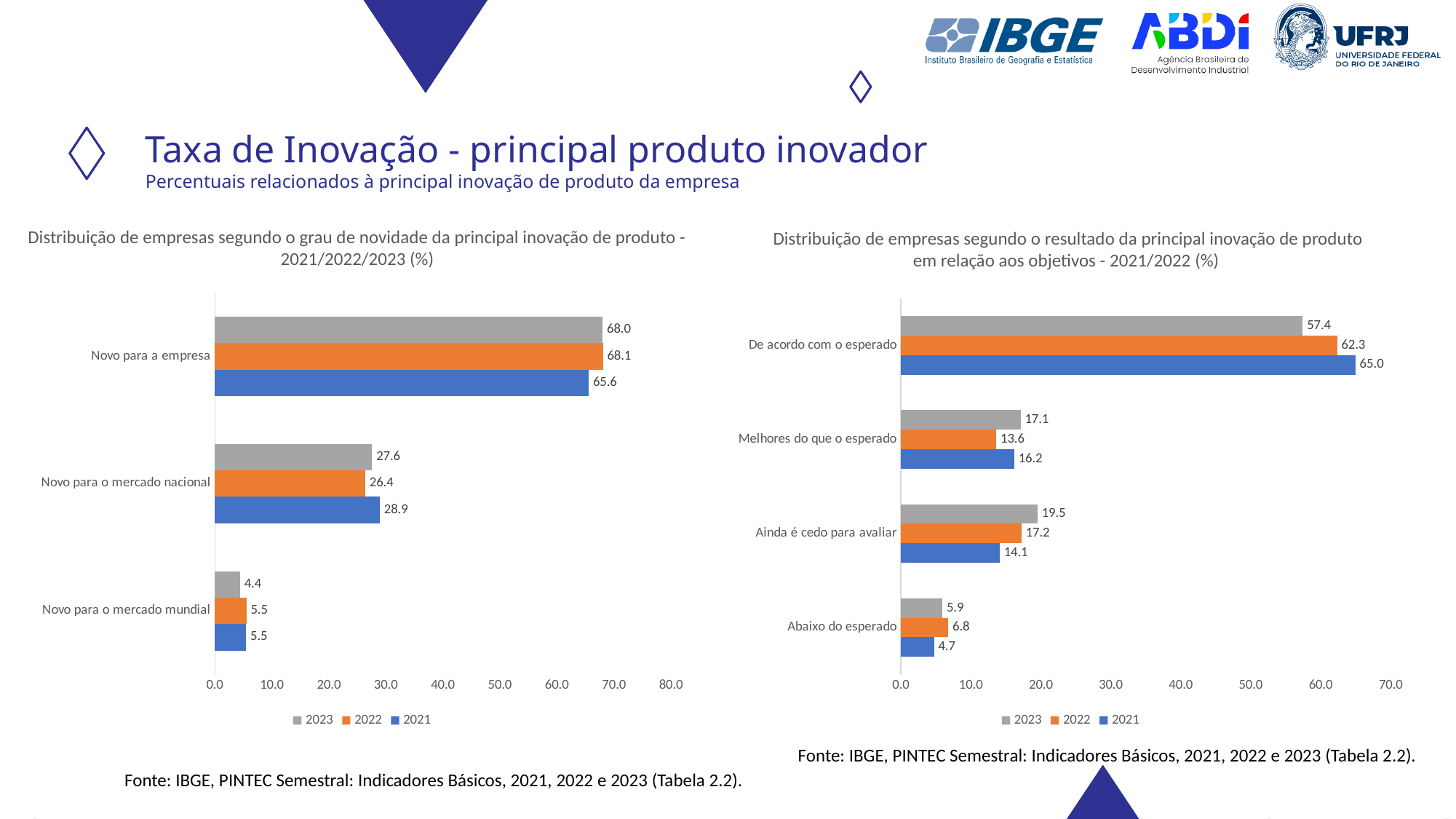
In the right chart (resultado em relação aos objetivos), what is the 2021 value for 'De acordo com o esperado'? 65.0 In the right chart (resultado em relação aos objetivos), which category has the highest 2023 value? De acordo com o esperado In the left chart (grau de novidade), which category has the lowest 2023 value? Novo para o mercado mundial In the left chart (grau de novidade), what is the 2023 value for 'Novo para a empresa'? 68.0 In the left chart (grau de novidade), what type of chart is shown? Bar chart In the right chart (resultado em relação aos objetivos), what is the difference between the 2021 and 2023 values for 'De acordo com o esperado'? 7.6 In the right chart (resultado em relação aos objetivos), how many categories are shown? 4 In the right chart (resultado em relação aos objetivos), what is the 2022 value for 'Abaixo do esperado'? 6.8 In the left chart (grau de novidade), what is the difference between the 2021 and 2022 values for 'Novo para o mercado nacional'? 2.5 In the right chart (resultado em relação aos objetivos), is the 2023 value for 'Melhores do que o esperado' larger or smaller than the 2023 value for 'Ainda é cedo para avaliar'? smaller In the left chart (grau de novidade), how many series does the legend list? 3 In the left chart (grau de novidade), what is the 2021 value for 'Novo para o mercado nacional'? 28.9